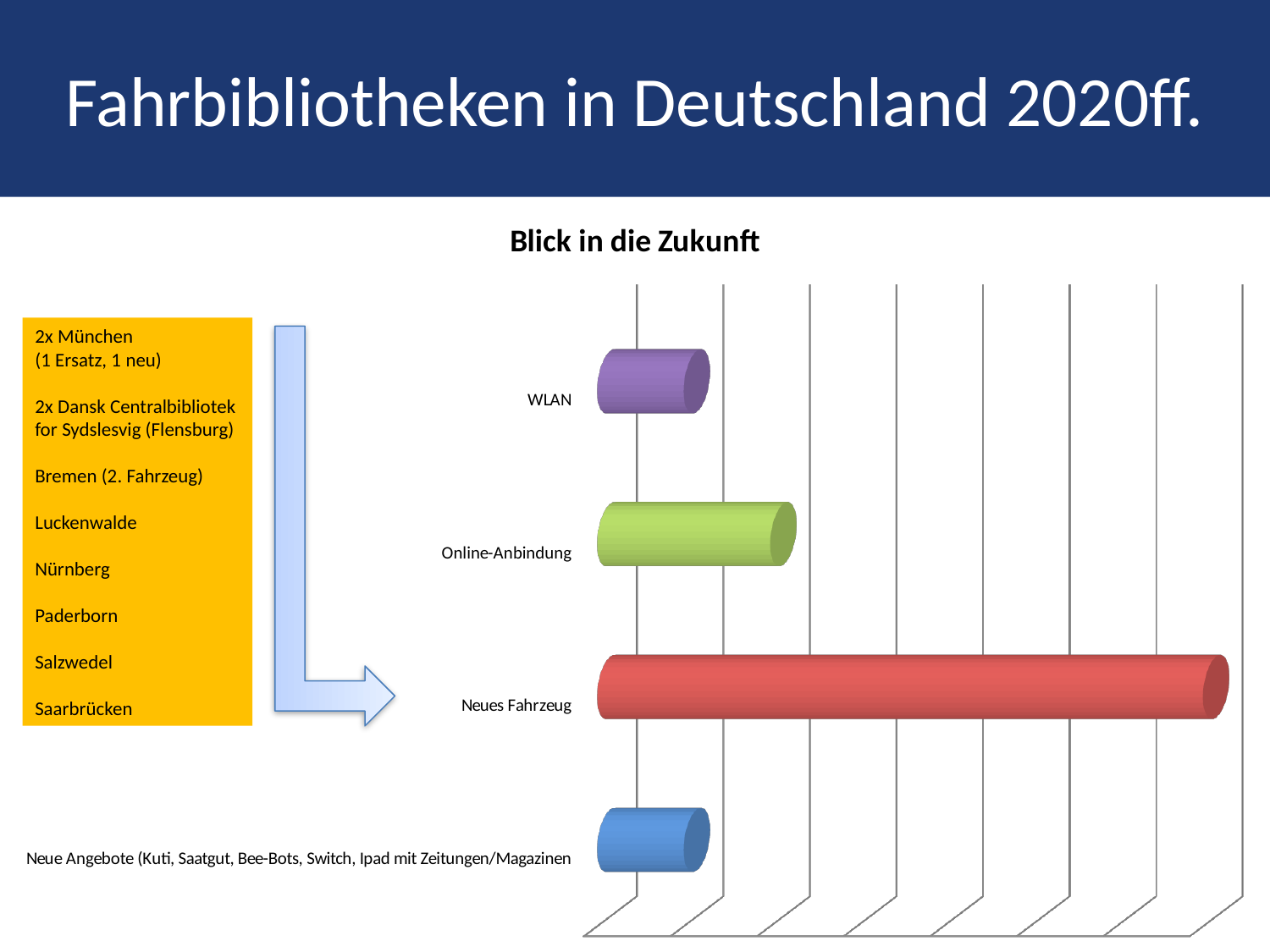
Which is larger, the value for Neues Fahrzeug or the value for Online-Anbindung? Neues Fahrzeug What kind of chart is shown on the slide? bar chart Which category has the highest value in the chart? Neues Fahrzeug What colour is the bar for Neues Fahrzeug? red How many categories does the chart show? 4 Which is larger, the value for Online-Anbindung or the value for WLAN? Online-Anbindung What is the title of the chart? Blick in die Zukunft Which is larger, the value for Neues Fahrzeug or the value for Neue Angebote (Kuti, Saatgut, Bee-Bots, Switch, Ipad mit Zeitungen/Magazinen)? Neues Fahrzeug